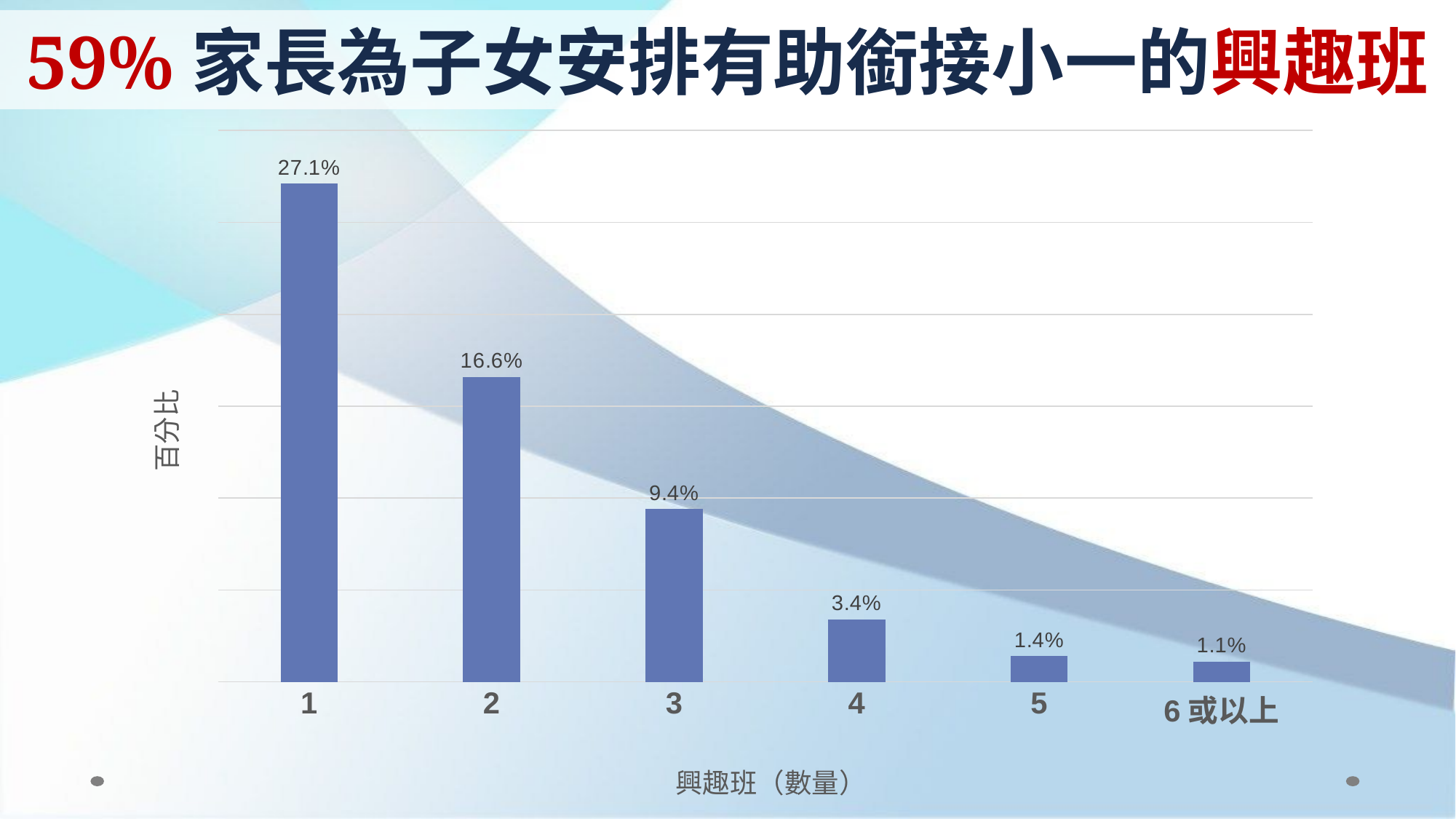
What kind of chart is shown on the slide? Bar chart Which category has the highest value on the chart? 1 What is the value shown for the category "6 或以上"? 1.1% What is the difference between the values for categories "4" and "5"? 2.0% Do the values rise or fall as you move from left to right along the x axis? Fall What is the difference between the values for categories "1" and "2"? 10.5% Which is larger, the value for category "3" or the value for category "4"? 3 Which category has the lowest value on the chart? 6 或以上 How many categories are shown on the x axis of the chart? 6 What is the value shown for the category "2" on the chart? 16.6% What percentage of parents arranged 1 interest class (興趣班) for their child? 27.1% What is the value shown for the category "3"? 9.4%